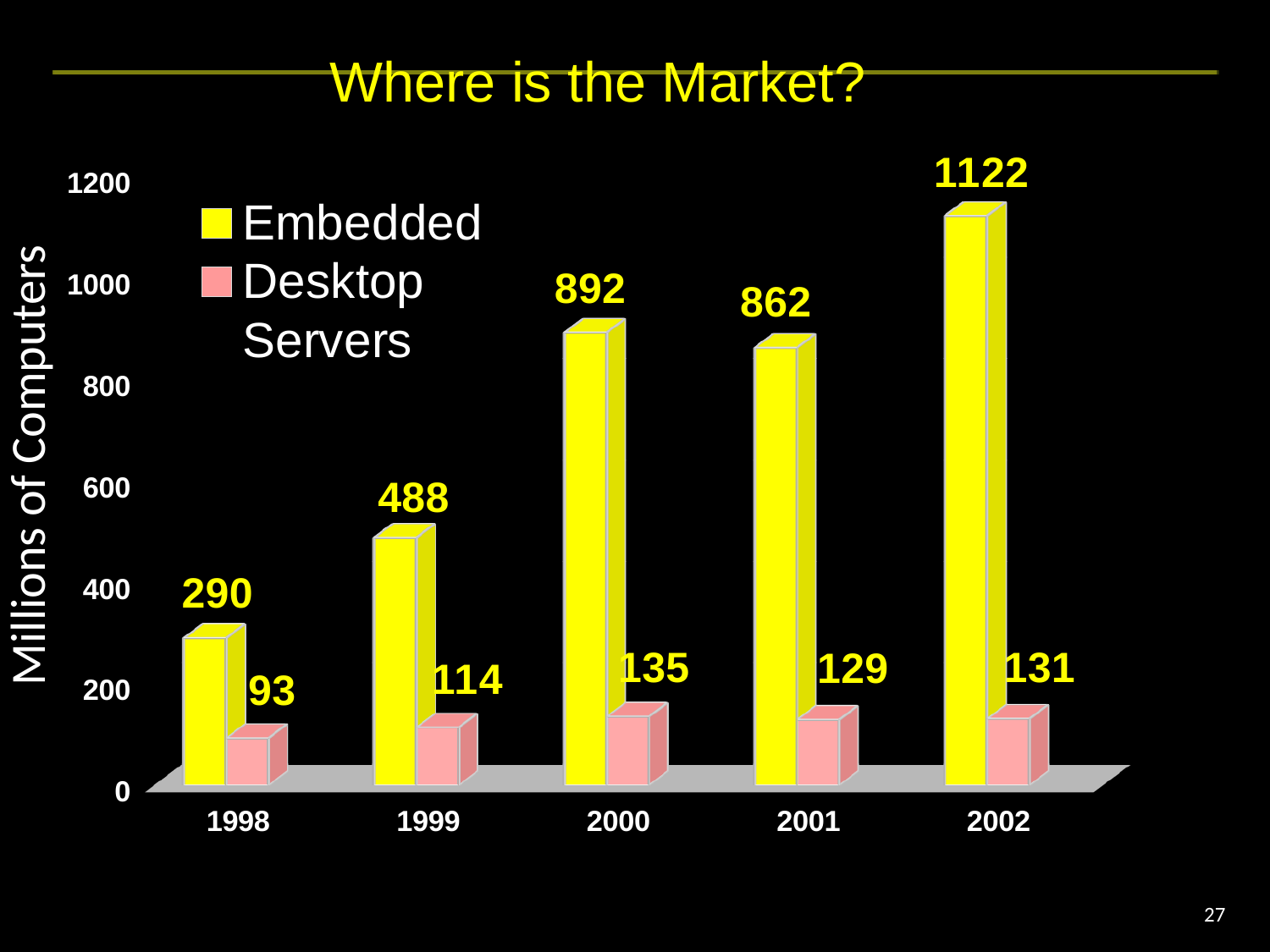
What is the title of the chart? Where is the Market? How many series does the legend list? 3 How many years are shown on the x axis? 5 What is the label on the vertical axis? Millions of Computers What kind of chart is shown on the slide? bar chart What is the difference between the Embedded values for 2000 and 2001? 30 What is the Embedded value for 2002? 1122 Which year has the highest Embedded value? 2002 What is the Embedded value for 1999? 488